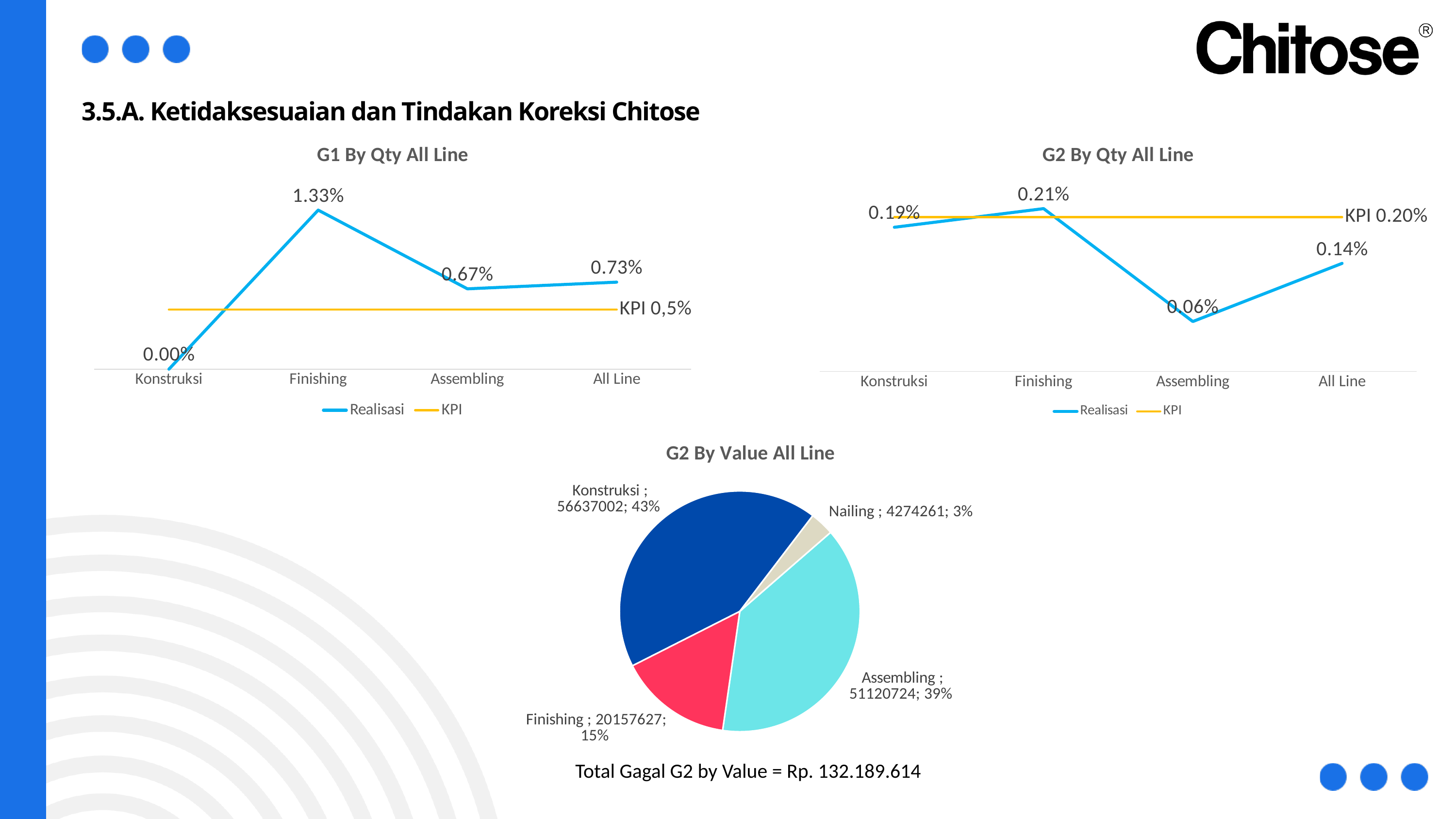
How many slices does the 'G2 By Value All Line' pie chart have? 4 In the 'G2 By Value All Line' pie chart, what share does Konstruksi have? 43% In the 'G2 By Qty All Line' chart, what is the Realisasi value for Assembling? 0.06% What type of chart is 'G2 By Value All Line'? Pie chart In the 'G2 By Qty All Line' chart, which category has the highest Realisasi value? Finishing In the 'G1 By Qty All Line' chart, which category has the lowest Realisasi value? Konstruksi In the 'G1 By Qty All Line' chart, which category has the highest Realisasi value? Finishing In the 'G2 By Qty All Line' chart, is the Realisasi value for Konstruksi or for All Line larger? Konstruksi In the 'G2 By Qty All Line' chart, what is the difference between the Realisasi values for Finishing and Assembling? 0.15% In the 'G1 By Qty All Line' chart, what is the KPI value shown? 0,5% In the 'G1 By Qty All Line' chart, what is the Realisasi value for Finishing? 1.33% In the 'G2 By Value All Line' pie chart, what is the value for Finishing? 20157627